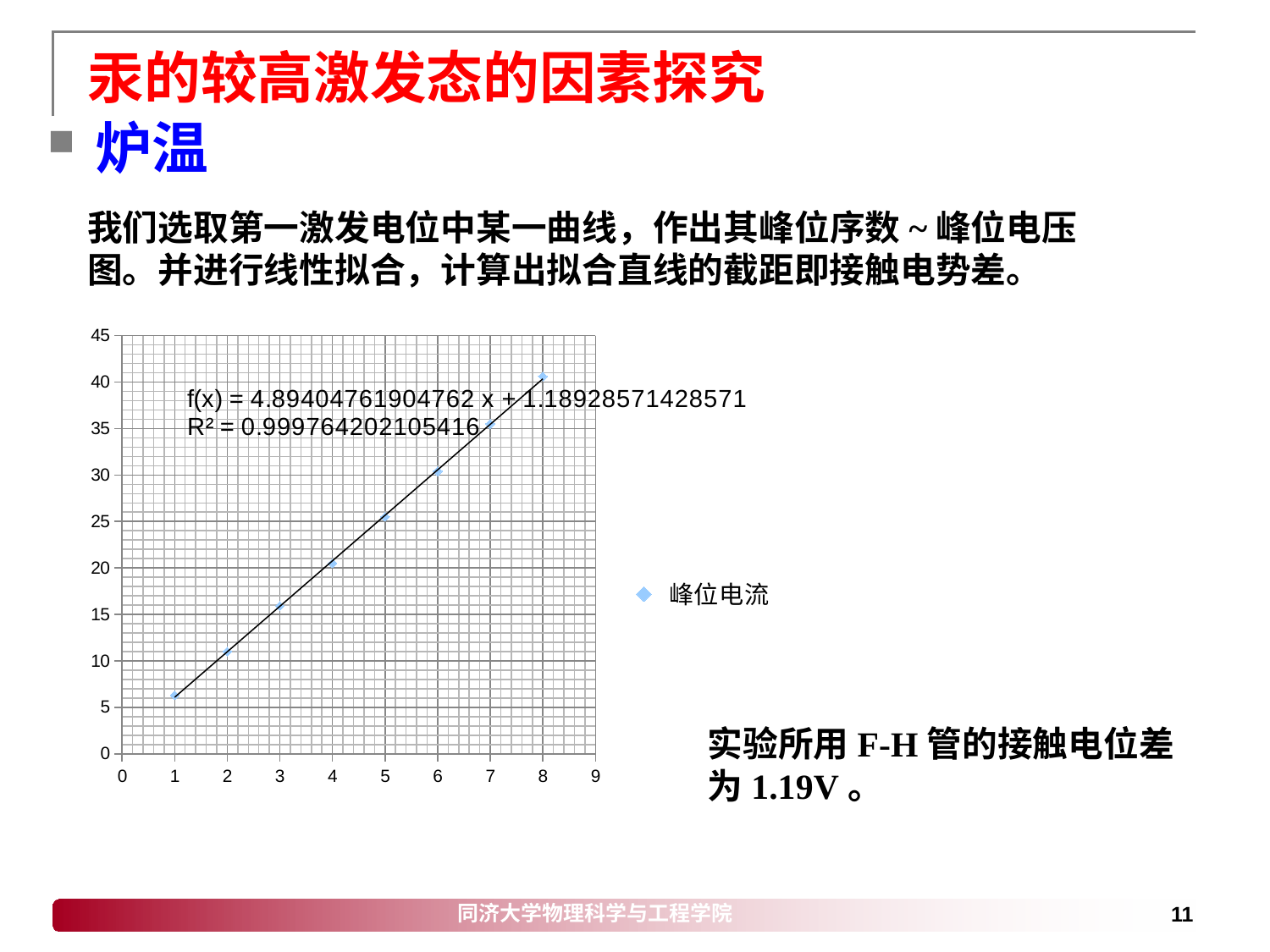
At which x value is the plotted value lowest? 1 What is the name of the series shown in the chart legend? 峰位电流 What kind of chart is shown on the slide? scatter chart Is the plotted value at x = 7 greater or less than 30? greater What R² value is printed for the fitted line on the chart? 0.999764202105416 How many data points are plotted in the chart? 8 Do the plotted values rise or fall as x increases from 1 to 8? rise Is the plotted value at x = 2 greater or less than 15? less Which has the larger plotted value, x = 3 or x = 6? x = 6 How many series does the chart legend list? 1 Is the plotted value at x = 5 greater or less than 20? greater At which x value is the plotted value highest? 8